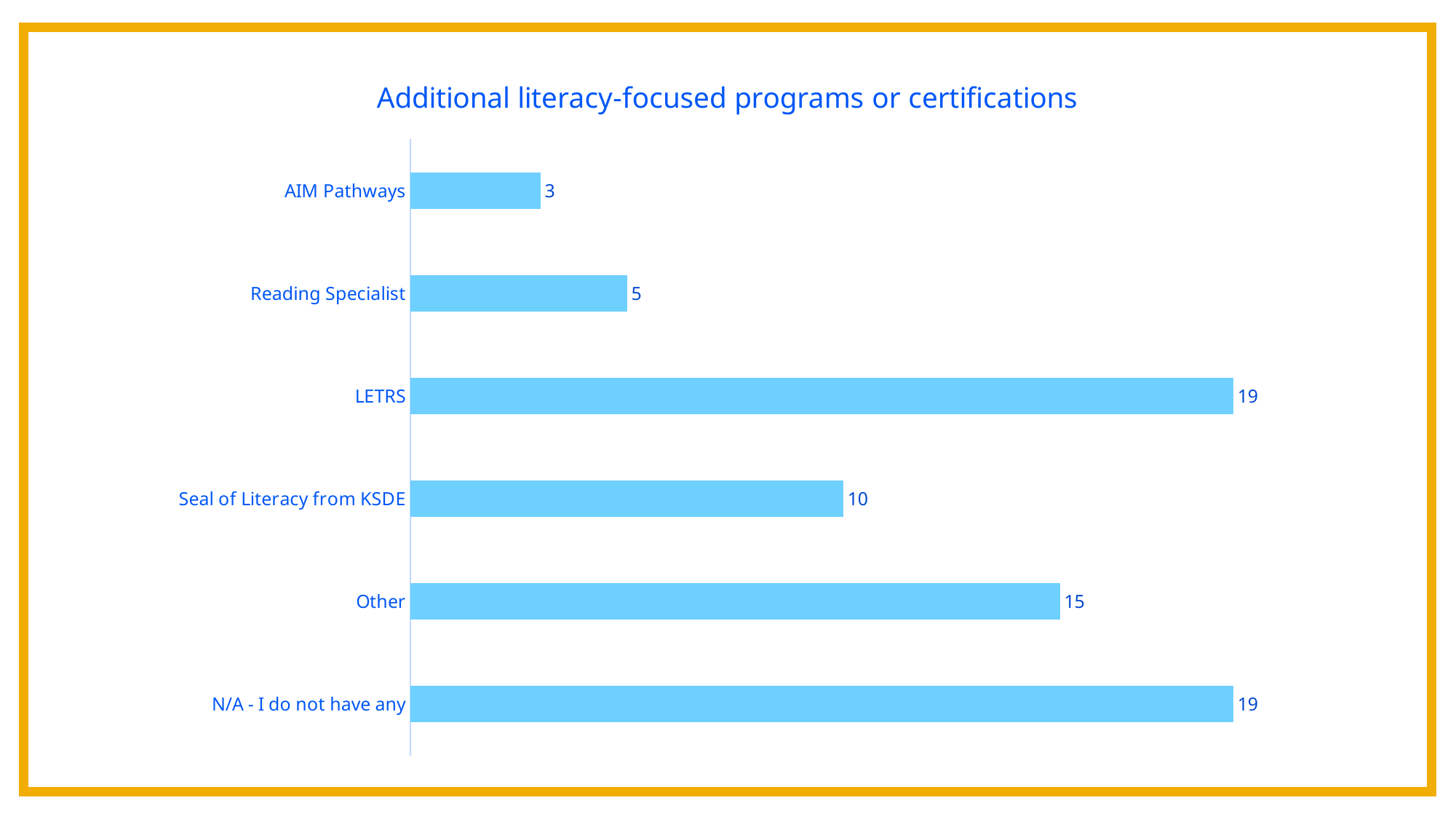
What is the value for Seal of Literacy from KSDE? 10 What is the difference between the values for LETRS and Seal of Literacy from KSDE? 9 What is the title of the chart? Additional literacy-focused programs or certifications Which is larger, the value for Seal of Literacy from KSDE or the value for Reading Specialist? Seal of Literacy from KSDE How many categories are shown in the chart? 6 Which is larger, the value for Other or the value for LETRS? LETRS What is the value for LETRS? 19 What is the value for AIM Pathways? 3 What is the difference between the values for Other and Reading Specialist? 10 What kind of chart is shown on the slide? Bar chart Which category has the lowest value? AIM Pathways What is the value for Other? 15